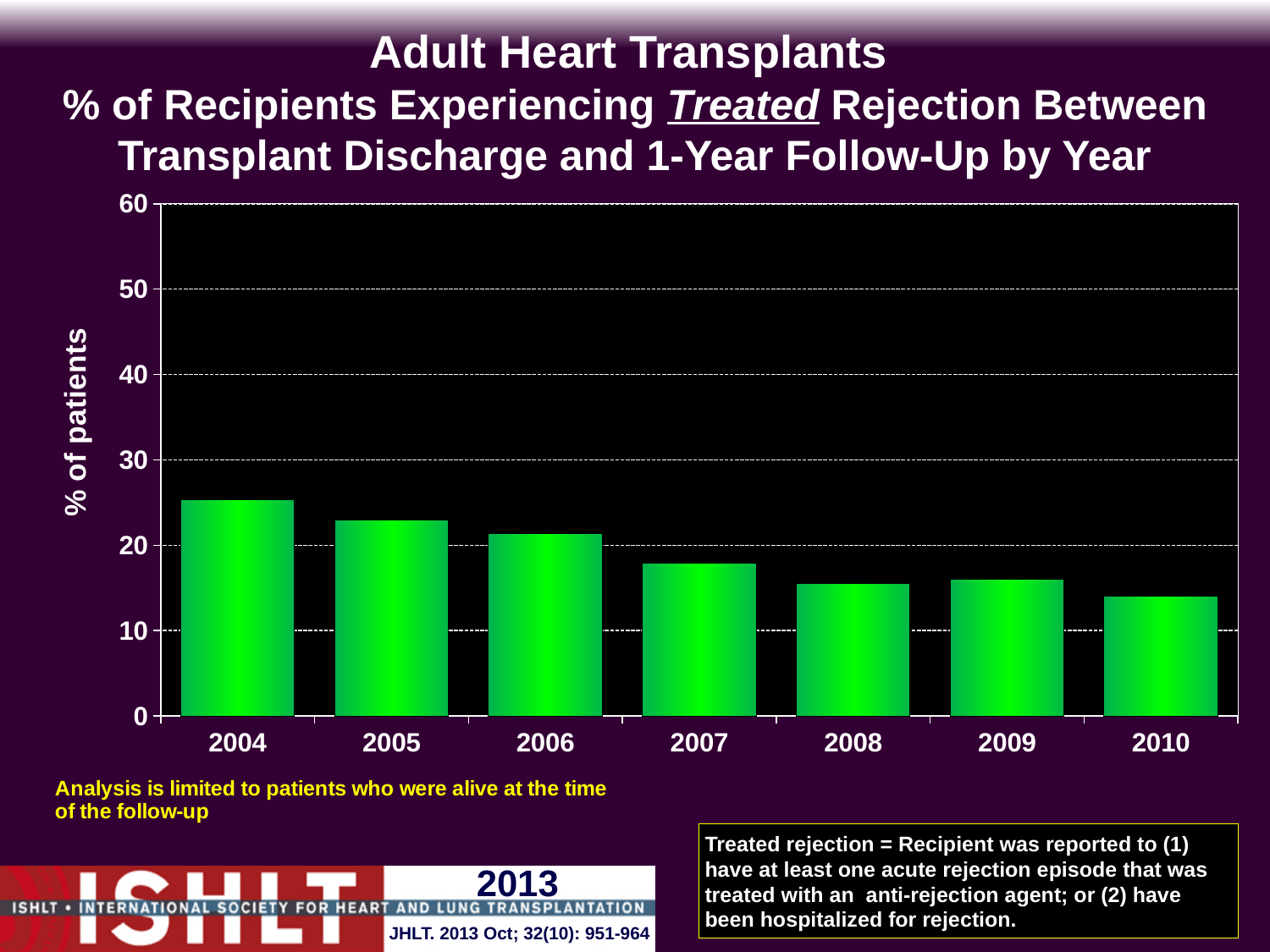
What is the label on the y axis of the chart? % of patients Is the value for 2010 greater or less than 10? greater Is the value for 2009 greater or less than 20? less How many years are shown on the x axis of the chart? 7 Do the values generally rise or fall from 2004 to 2010? Fall Is the value for 2007 greater or less than 20? less What kind of chart is shown on the slide? Bar chart Which is larger, the value for 2006 or the value for 2010? 2006 Which is larger, the value for 2004 or the value for 2007? 2004 Which year has the highest percentage of patients experiencing treated rejection? 2004